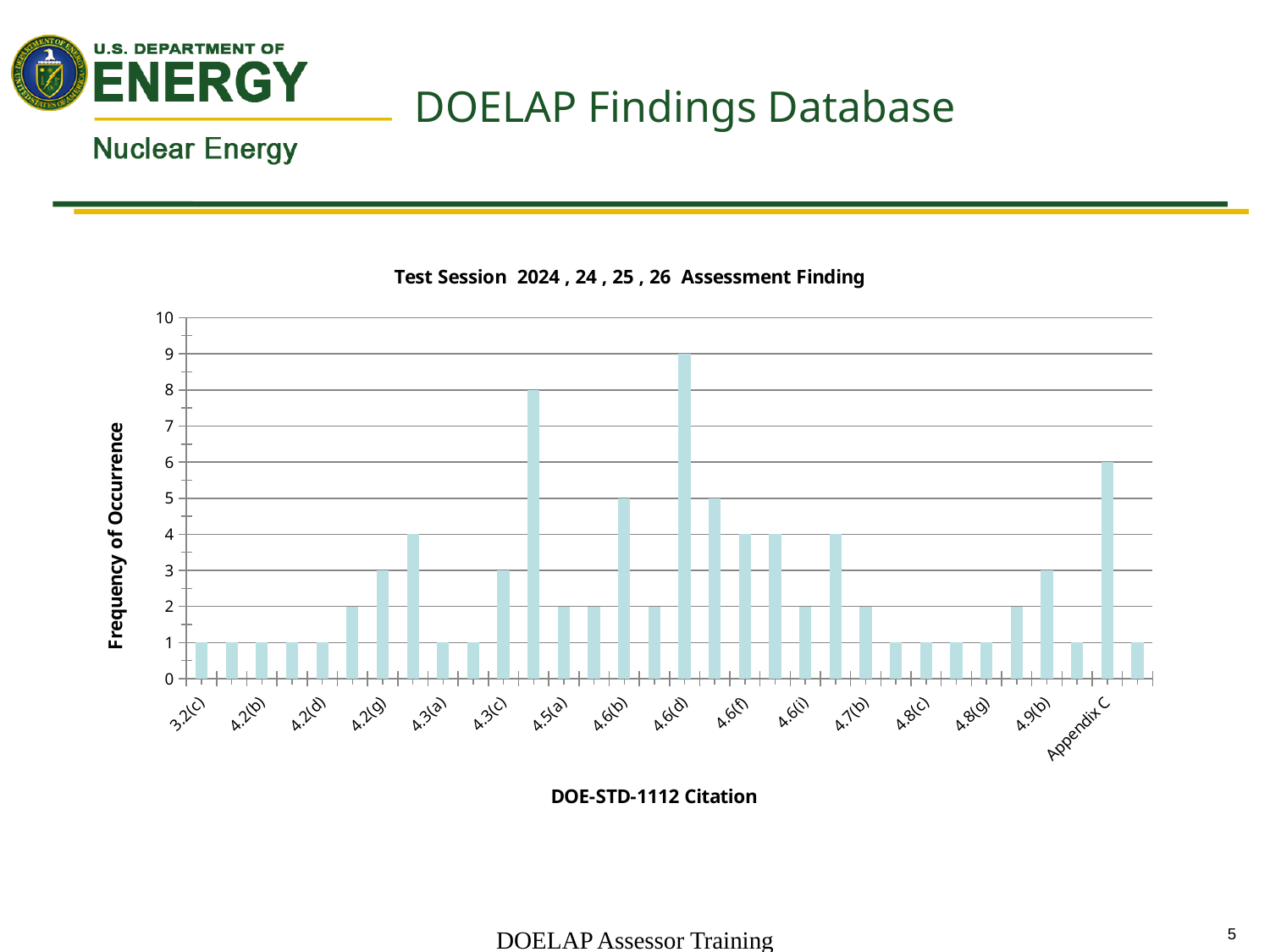
What is the label of the x axis? DOE-STD-1112 Citation What is the frequency of occurrence for citation 4.6(d)? 9 What is the title of the chart? Test Session 2024 , 24 , 25 , 26 Assessment Finding Is the frequency of occurrence for citation 4.6(d) greater or less than 8? greater Which labeled citation has the highest frequency of occurrence? 4.6(d) What is the frequency of occurrence for citation 4.2(g)? 3 What is the difference in frequency between citation 4.6(d) and Appendix C? 3 What type of chart is shown on the slide? bar chart Which has a higher frequency of occurrence, citation 4.6(f) or citation 4.9(b)? 4.6(f) What is the frequency of occurrence for citation 3.2(c)? 1 What is the frequency of occurrence for Appendix C? 6 What is the frequency of occurrence for citation 4.6(b)? 5